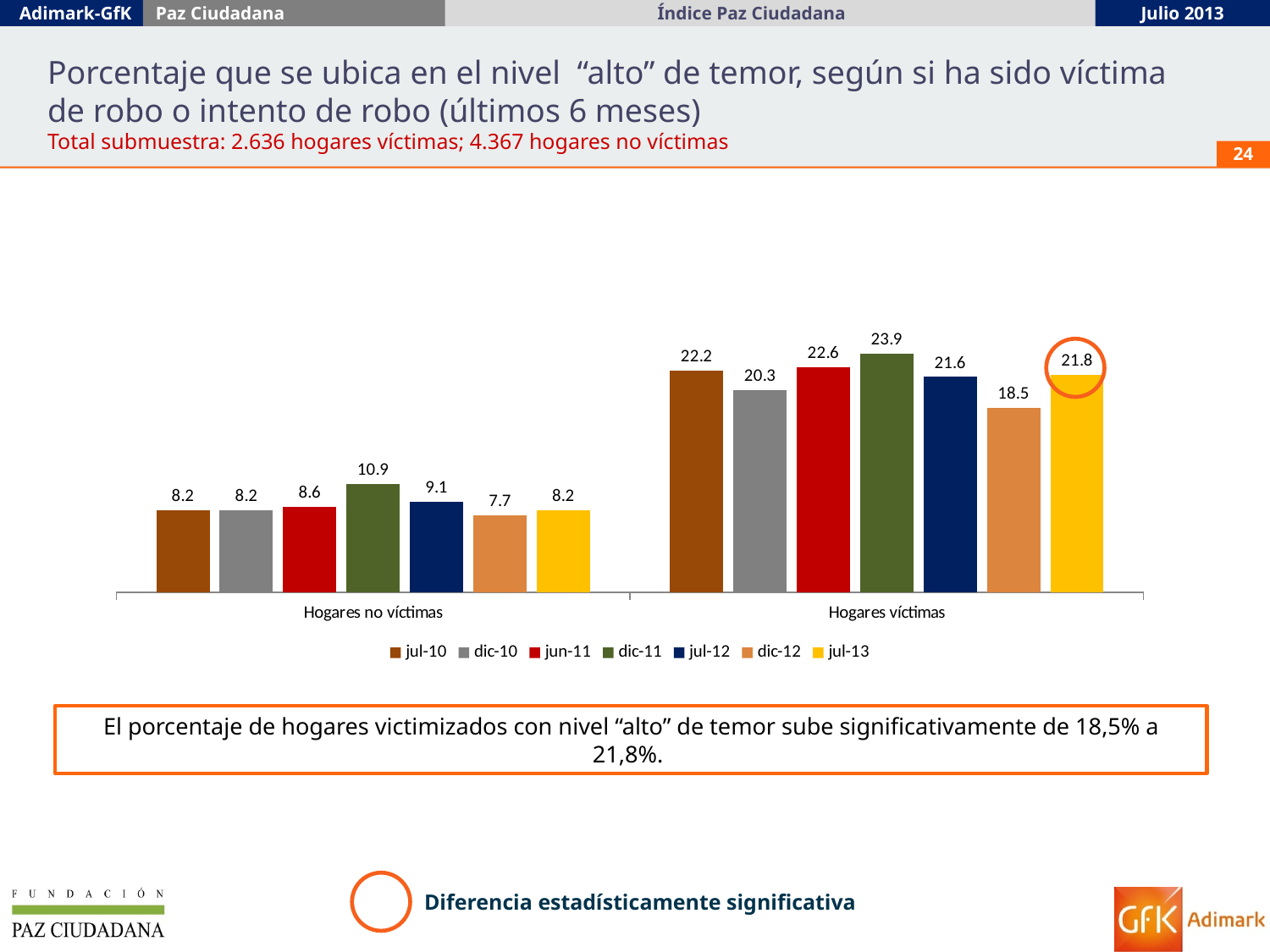
Which bar is circled on the chart? jul-13 for Hogares víctimas What is the value for dic-11 in the Hogares no víctimas group? 10.9 What is the value for jul-13 in the Hogares víctimas group? 21.8 How many category groups are shown on the x axis? 2 Which series has the highest value in the Hogares víctimas group? dic-11 What is the value for dic-12 in the Hogares víctimas group? 18.5 How many series does the legend list? 7 What is the difference between the jul-13 and dic-12 values in the Hogares víctimas group? 3.3 Which series has the lowest value in the Hogares no víctimas group? dic-12 What is the difference between the dic-11 and jul-10 values in the Hogares no víctimas group? 2.7 What kind of chart is shown on the slide? Bar chart Which is larger: the jun-11 value for Hogares víctimas or the jul-12 value for Hogares víctimas? jun-11